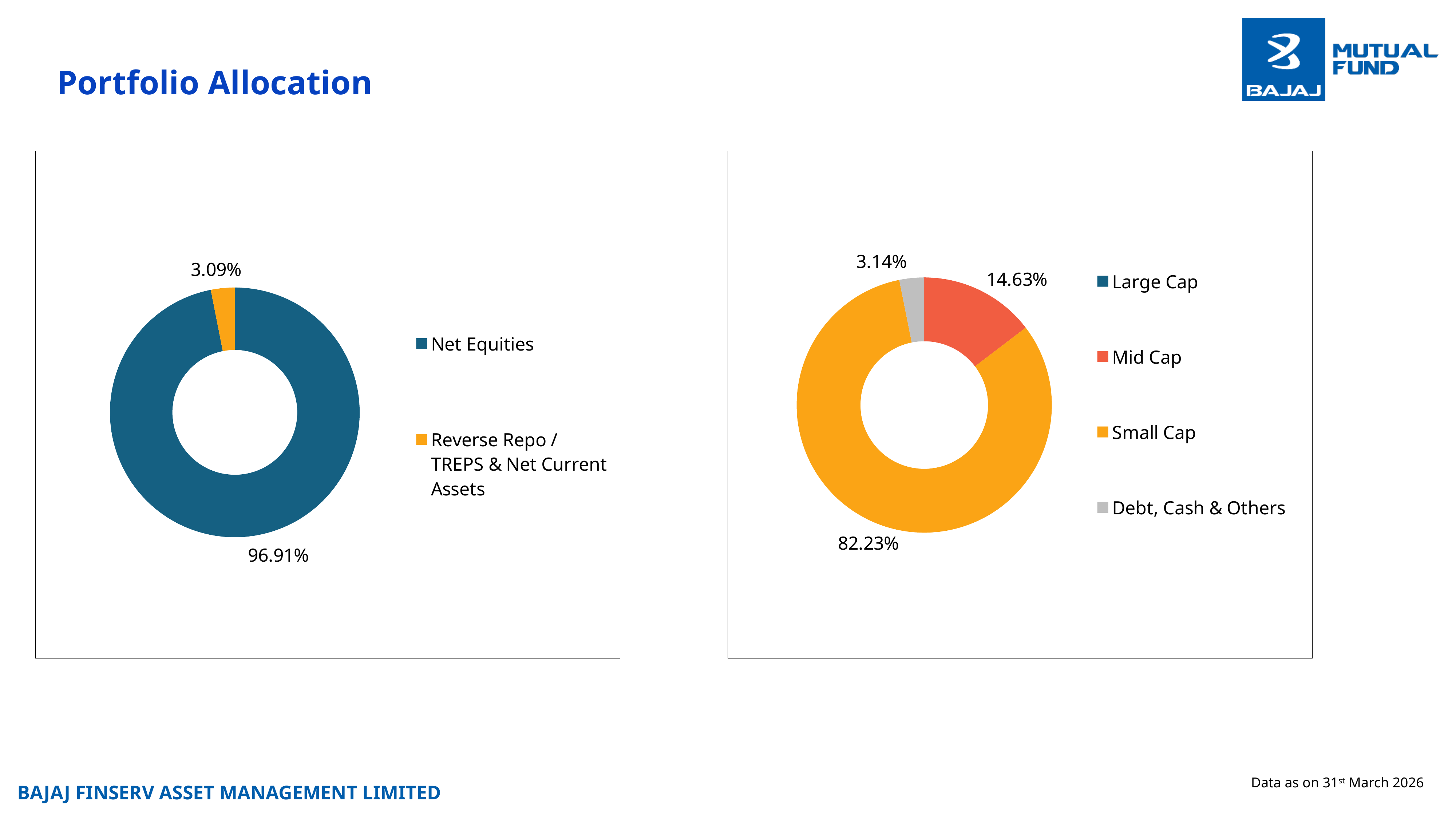
In the right chart, which category has the largest share? Small Cap In the left chart, which category has the largest share? Net Equities In the right chart, which is larger, Mid Cap or Debt, Cash & Others? Mid Cap In the left chart, what is the difference between Net Equities and Reverse Repo / TREPS & Net Current Assets? 93.82% In the left chart, what is the value for Reverse Repo / TREPS & Net Current Assets? 3.09% In the left chart, what is the value for Net Equities? 96.91% In the right chart, what is the value for Small Cap? 82.23% What kind of chart is the left chart? Doughnut chart In the right chart, what is the value for Mid Cap? 14.63% In the right chart, what is the difference between Small Cap and Mid Cap? 67.60% In the right chart, what is the value for Debt, Cash & Others? 3.14% How many entries does the legend of the right chart list? 4